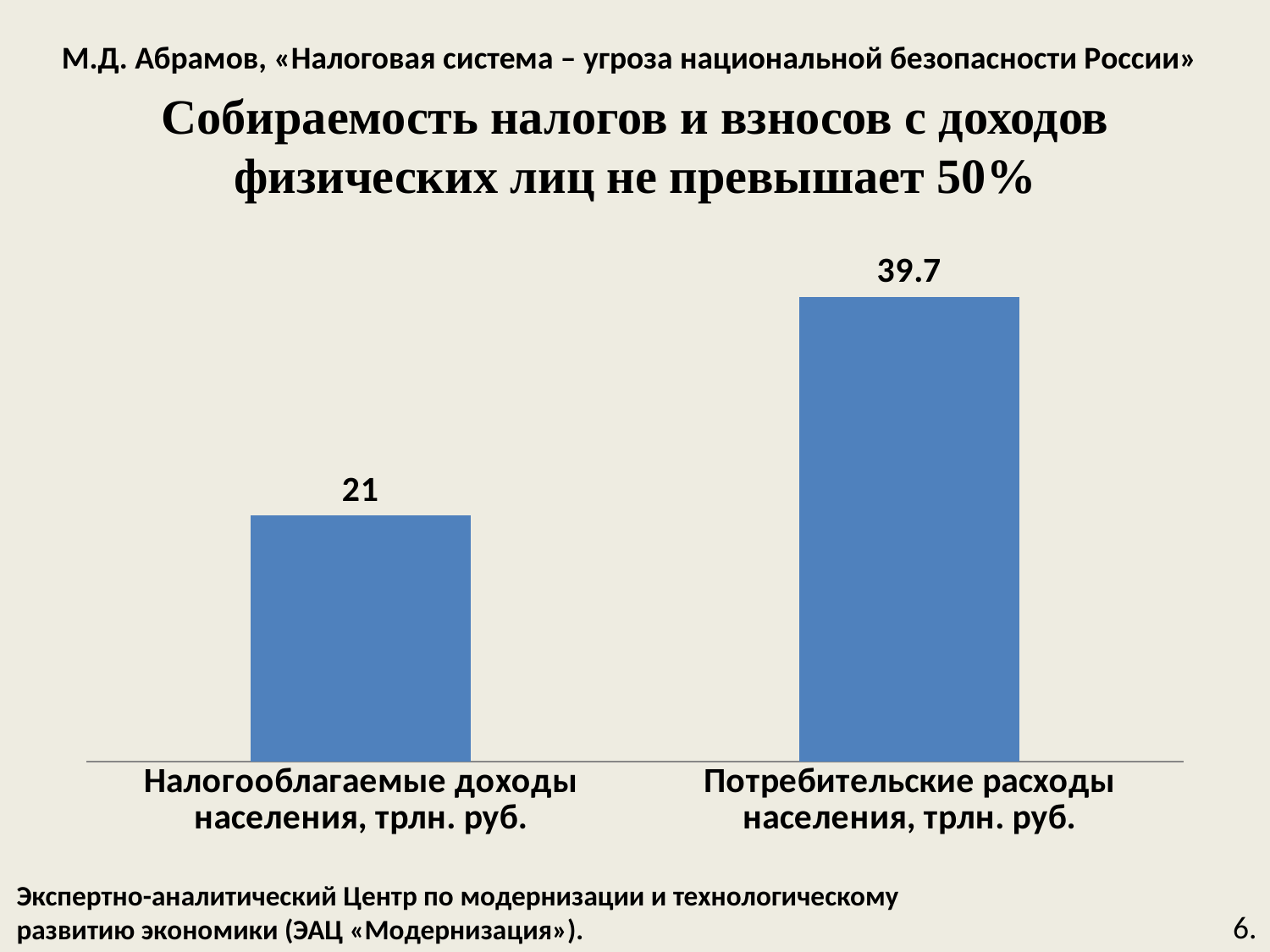
What is the difference between Потребительские расходы населения and Налогооблагаемые доходы населения? 18.7 Which category has the lowest value? Налогооблагаемые доходы населения, трлн. руб. Do the values rise or fall from left to right along the x axis? Rise Which is larger: Налогооблагаемые доходы населения or Потребительские расходы населения? Потребительские расходы населения What is the value for Потребительские расходы населения, трлн. руб.? 39.7 What colour are the bars in the chart? Blue What is the value for Налогооблагаемые доходы населения, трлн. руб.? 21 What kind of chart is shown on the slide? Bar chart What is the title of the slide above the chart? Собираемость налогов и взносов с доходов физических лиц не превышает 50% Which category has the highest value? Потребительские расходы населения, трлн. руб. How many categories are shown in the chart? 2